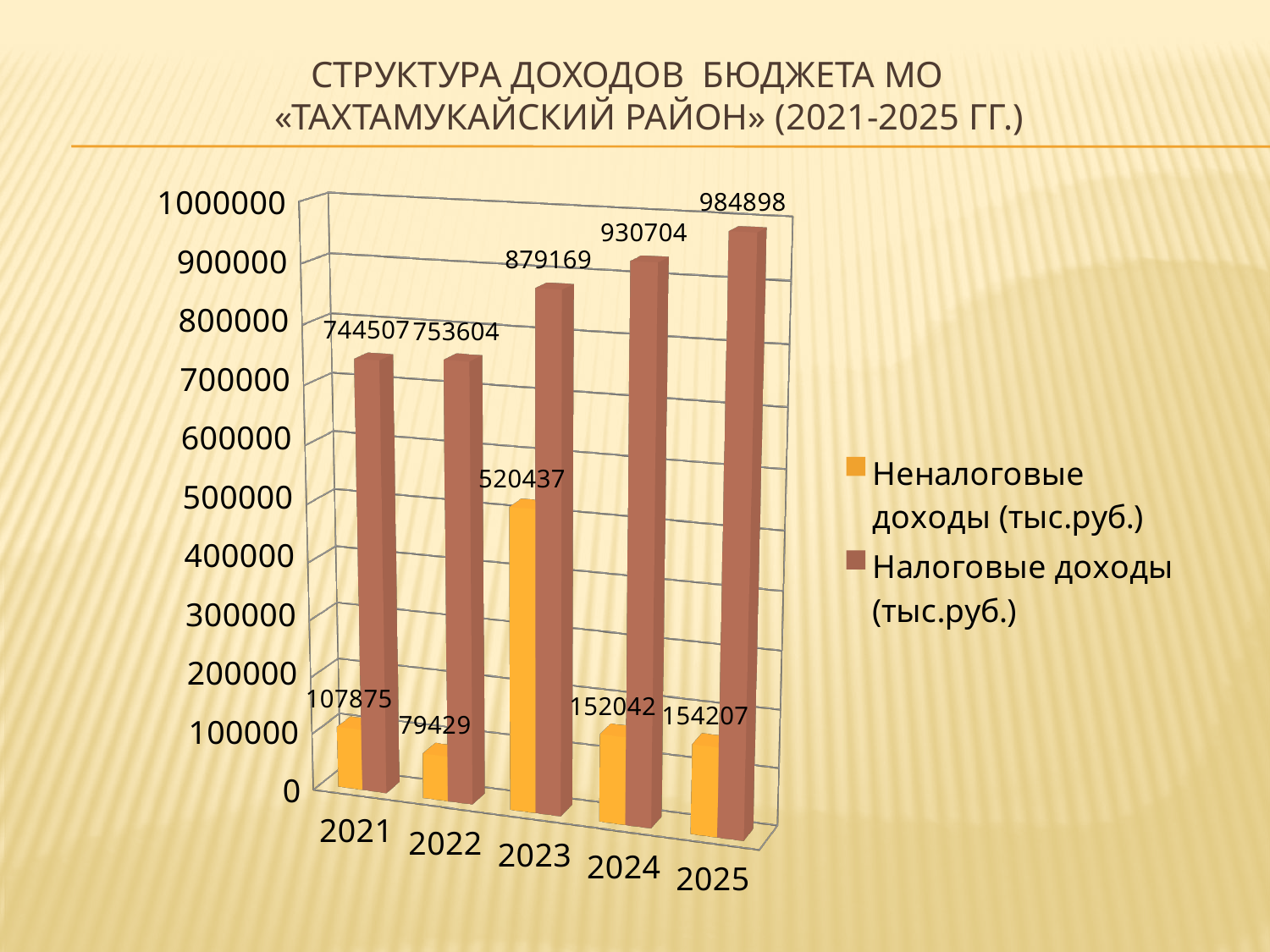
What is the difference between Налоговые доходы (тыс.руб.) in 2025 and in 2021? 240391 Which year has the highest value of Налоговые доходы (тыс.руб.)? 2025 What is the value of Налоговые доходы (тыс.руб.) for 2023? 879169 Which is larger: Неналоговые доходы (тыс.руб.) in 2024 or in 2021? 2024 What is the value of Неналоговые доходы (тыс.руб.) for 2025? 154207 How many years are shown on the x axis? 5 Which colour represents Неналоговые доходы (тыс.руб.) in the legend? orange Which year has the lowest value of Неналоговые доходы (тыс.руб.)? 2022 Do the values of Налоговые доходы (тыс.руб.) rise or fall from 2021 to 2025? rise How many series does the legend list? 2 What is the value of Неналоговые доходы (тыс.руб.) for 2022? 79429 What kind of chart is shown on the slide? bar chart